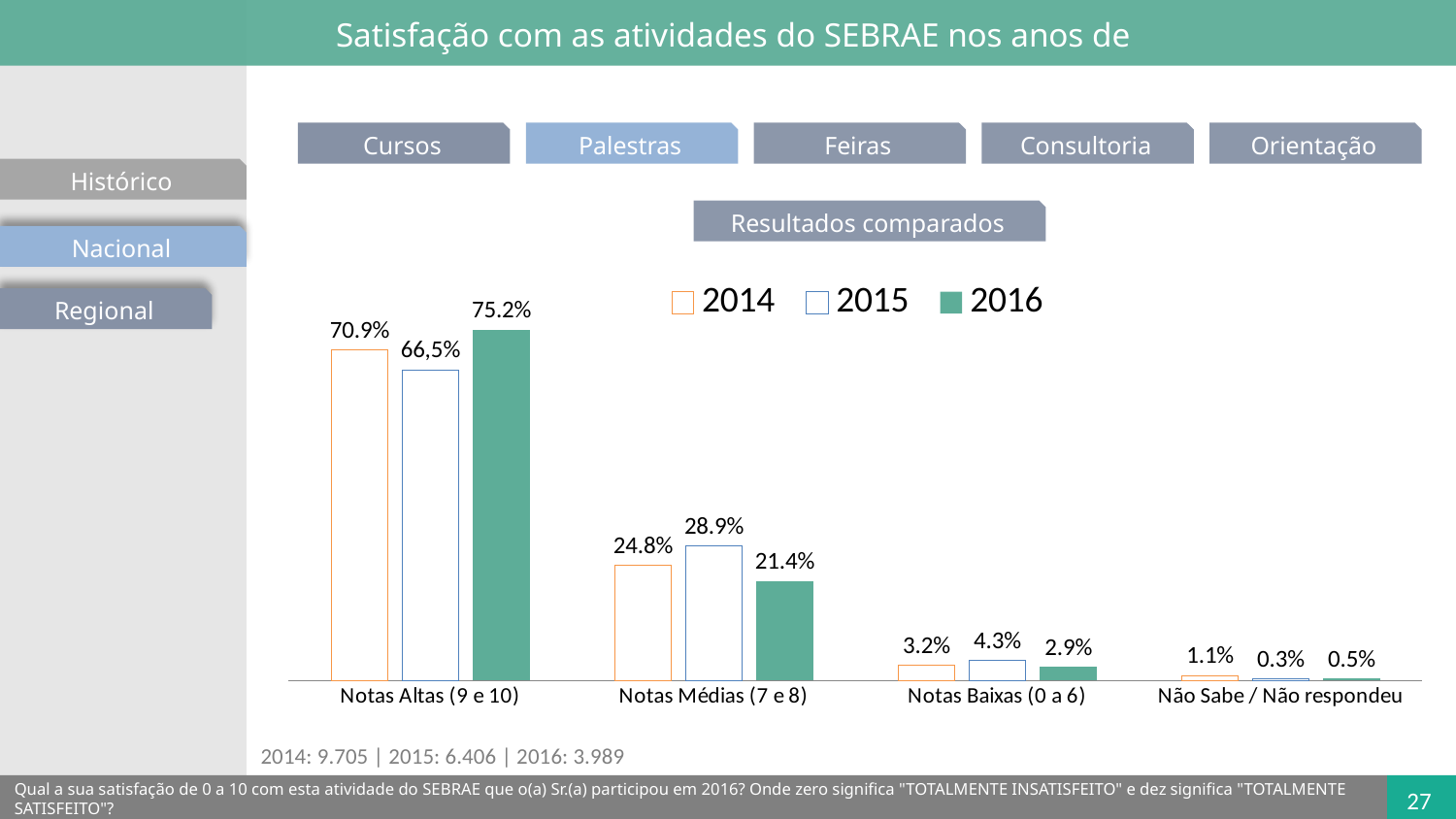
Which is larger in the Notas Baixas (0 a 6) category: the 2015 value or the 2016 value? 2015 How many categories are shown on the x axis of the chart? 4 What is the value for 2015 in the Não Sabe / Não respondeu category? 0.3% What is the difference between the 2015 and 2016 values in the Notas Médias (7 e 8) category? 7.5% Which colour represents the 2016 series in the chart? Green What is the value for 2014 in the Notas Baixas (0 a 6) category? 3.2% What kind of chart is shown on the slide? Bar chart Which year has the highest value in the Notas Altas (9 e 10) category? 2016 What is the value for 2016 in the Notas Altas (9 e 10) category? 75.2% How many series does the chart legend list? 3 What is the value for 2015 in the Notas Médias (7 e 8) category? 28.9% Which year has the lowest value in the Notas Médias (7 e 8) category? 2016